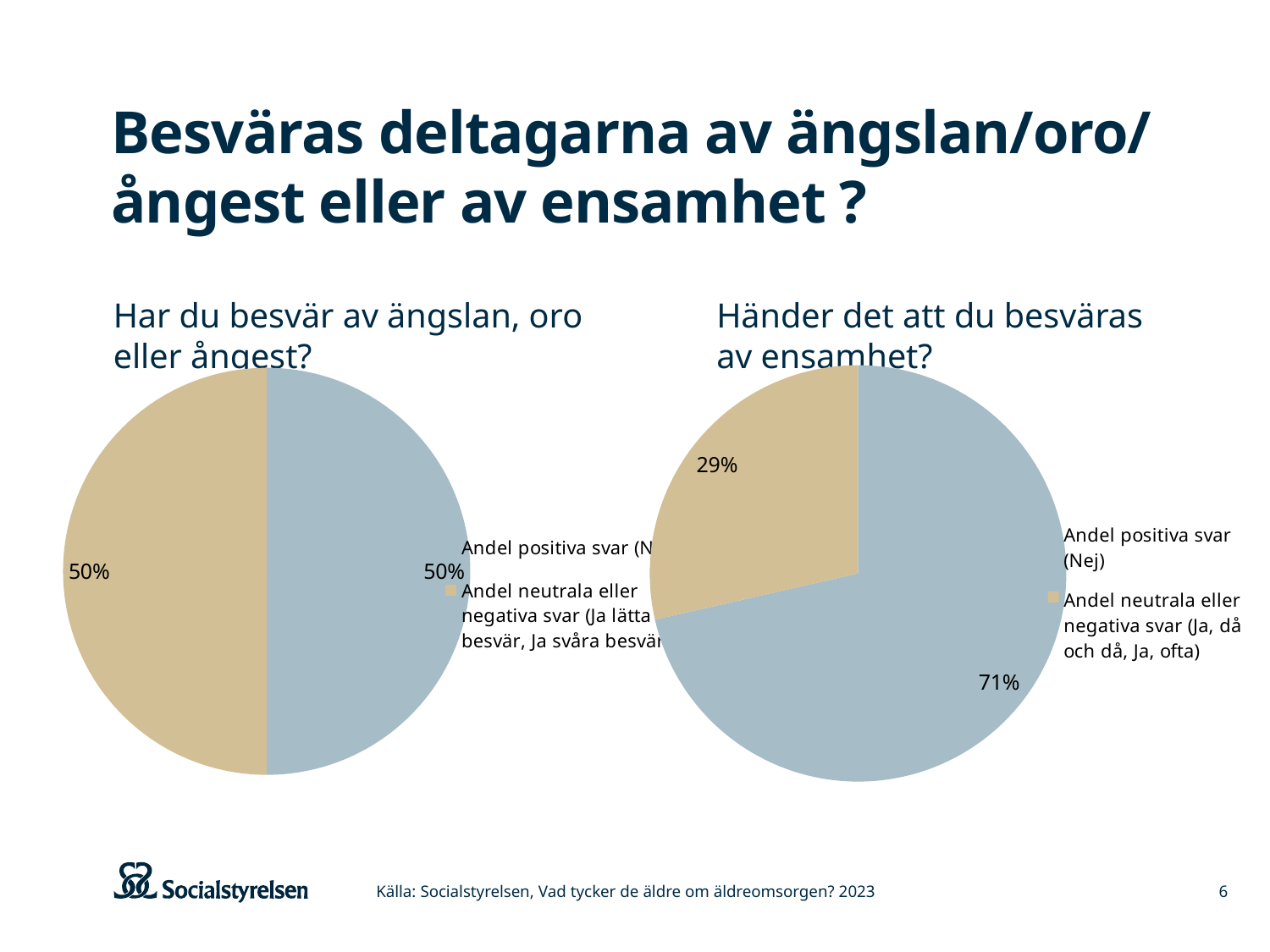
How many entries does the legend of the 'Händer det att du besväras av ensamhet?' chart list? 2 In the 'Händer det att du besväras av ensamhet?' chart, what share is 'Andel neutrala eller negativa svar (Ja, då och då, Ja, ofta)'? 29% In the 'Händer det att du besväras av ensamhet?' chart, which slice is the largest? Andel positiva svar (Nej) In the 'Har du besvär av ängslan, oro eller ångest?' chart, what share is 'Andel positiva svar'? 50% In the 'Händer det att du besväras av ensamhet?' chart, is the 'Andel positiva svar (Nej)' slice larger or smaller than the 'Andel neutrala eller negativa svar' slice? Larger In the 'Har du besvär av ängslan, oro eller ångest?' chart, what share is 'Andel neutrala eller negativa svar'? 50% In the 'Händer det att du besväras av ensamhet?' chart, what share is 'Andel positiva svar (Nej)'? 71% How many pie charts are shown on the slide? 2 In the 'Händer det att du besväras av ensamhet?' chart, what is the difference between the 'Andel positiva svar (Nej)' slice and the 'Andel neutrala eller negativa svar' slice? 42 percentage points How many slices does the 'Har du besvär av ängslan, oro eller ångest?' pie chart have? 2 In the 'Händer det att du besväras av ensamhet?' chart, which slice is the smallest? Andel neutrala eller negativa svar (Ja, då och då, Ja, ofta) What kind of chart is used for 'Händer det att du besväras av ensamhet?'? Pie chart